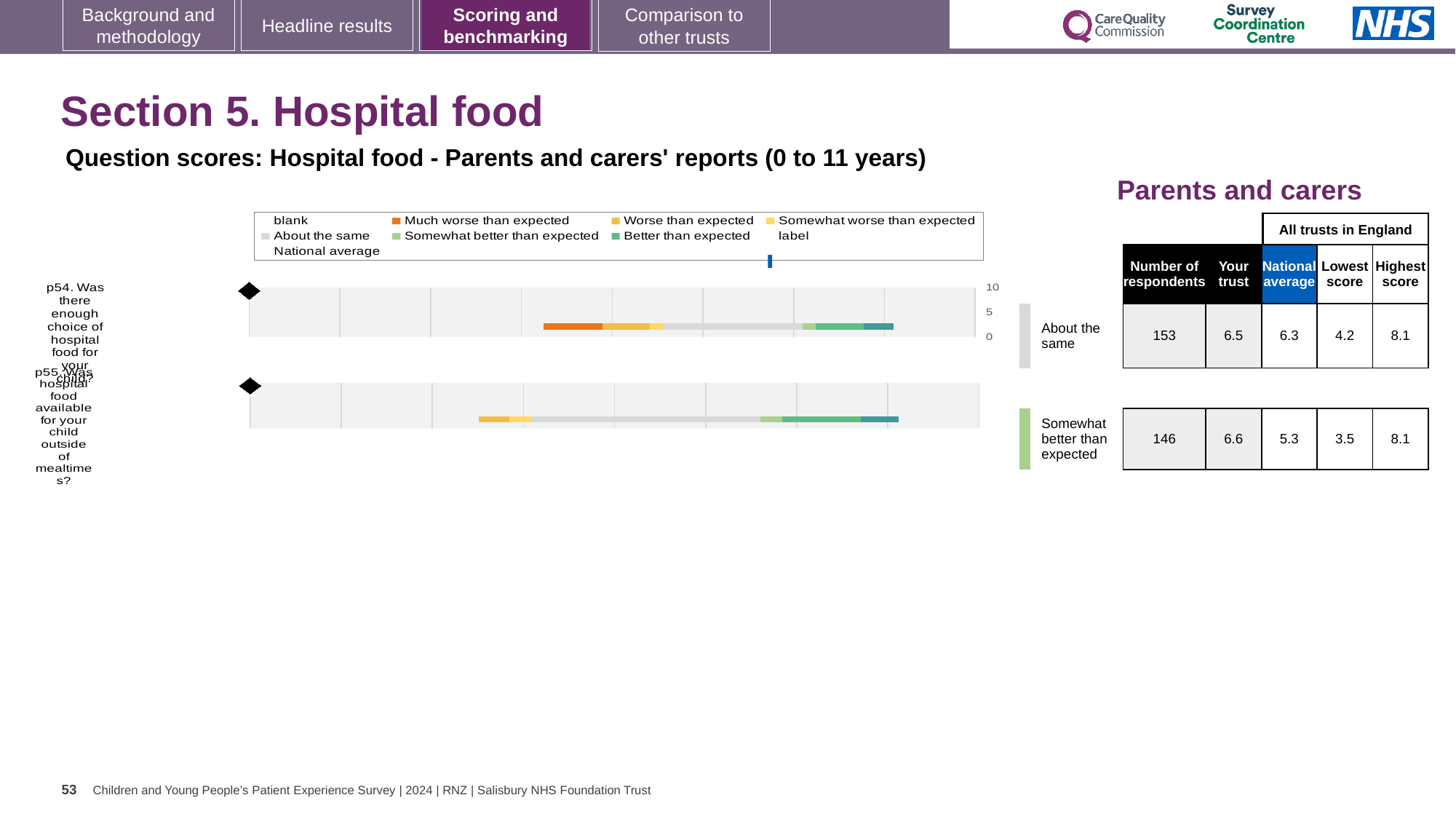
Which colour in the legend represents 'Much worse than expected'? orange What is the national average score for p55 (hospital food available outside of mealtimes)? 5.3 What kind of chart is shown on the slide? bar chart What is the difference between the 'Your trust' score and the national average for p55 (food available outside of mealtimes)? 1.3 For p55 (food available outside of mealtimes), which is larger: the 'Your trust' score or the national average? Your trust What is the maximum value shown on the chart's score axis? 10 How many respondents answered p54 (enough choice of hospital food for your child)? 153 What is the lowest score among all trusts in England for p55 (food available outside of mealtimes)? 3.5 Which benchmark category is p55 (food available outside of mealtimes) placed in? Somewhat better than expected What is the highest score among all trusts in England for p54 (enough choice of hospital food)? 8.1 How many questions (bars) are plotted in the chart? 2 What is the 'Your trust' score for p54 (enough choice of hospital food)? 6.5